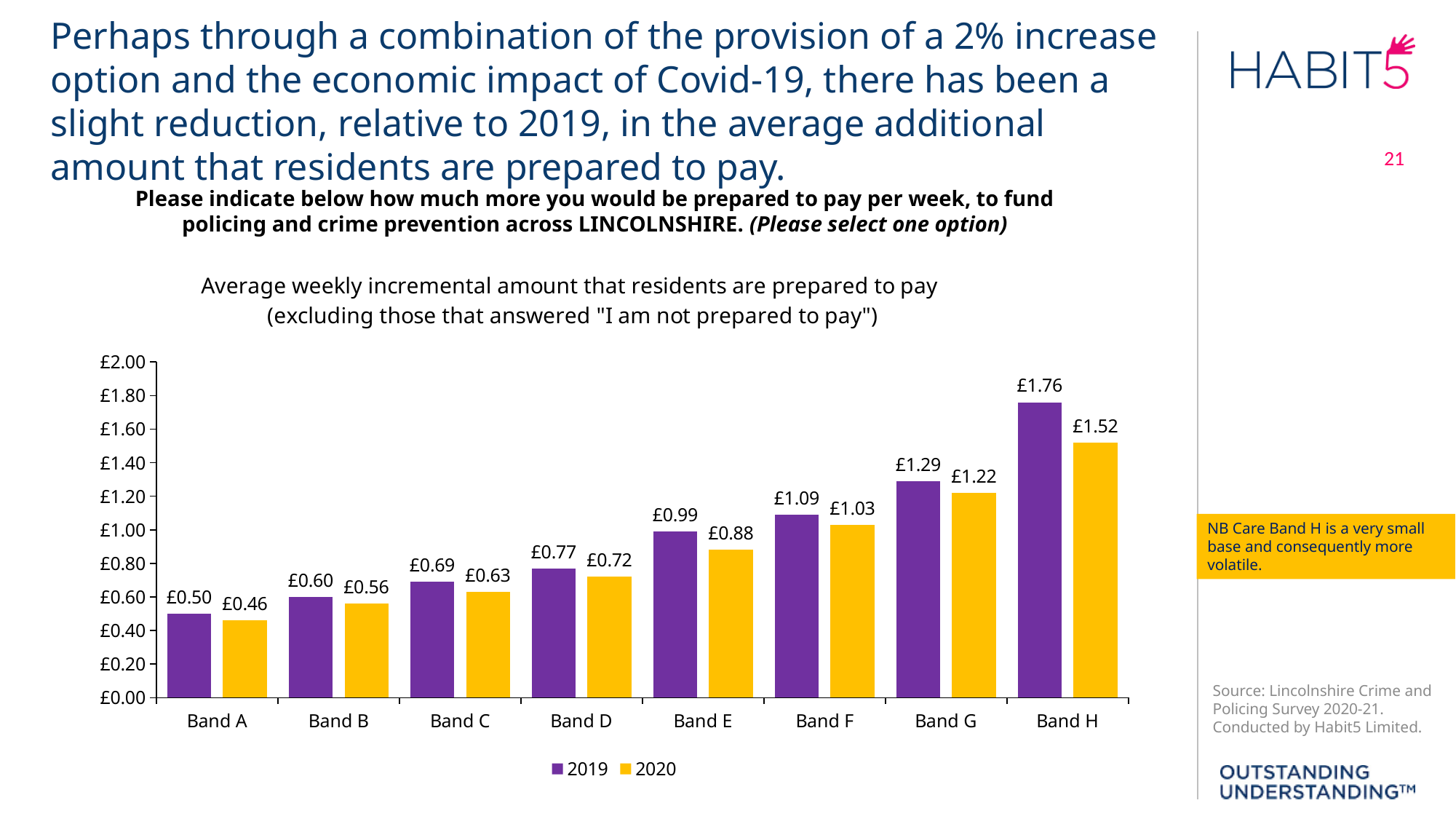
Which band has the highest 2020 value? Band H What is the 2019 value for Band H? £1.76 What kind of chart is shown on the slide? Bar chart Which is larger for Band C: the 2019 value or the 2020 value? 2019 What is the difference between the 2019 and 2020 values for Band H? £0.24 Do the 2020 values rise or fall from Band A to Band H? Rise How many bands are shown on the x axis? 8 What is the 2019 value for Band E? £0.99 What is the 2020 value for Band D? £0.72 How many series does the legend list? 2 What is the difference between the 2019 values for Band G and Band F? £0.20 Which band has the lowest 2019 value? Band A